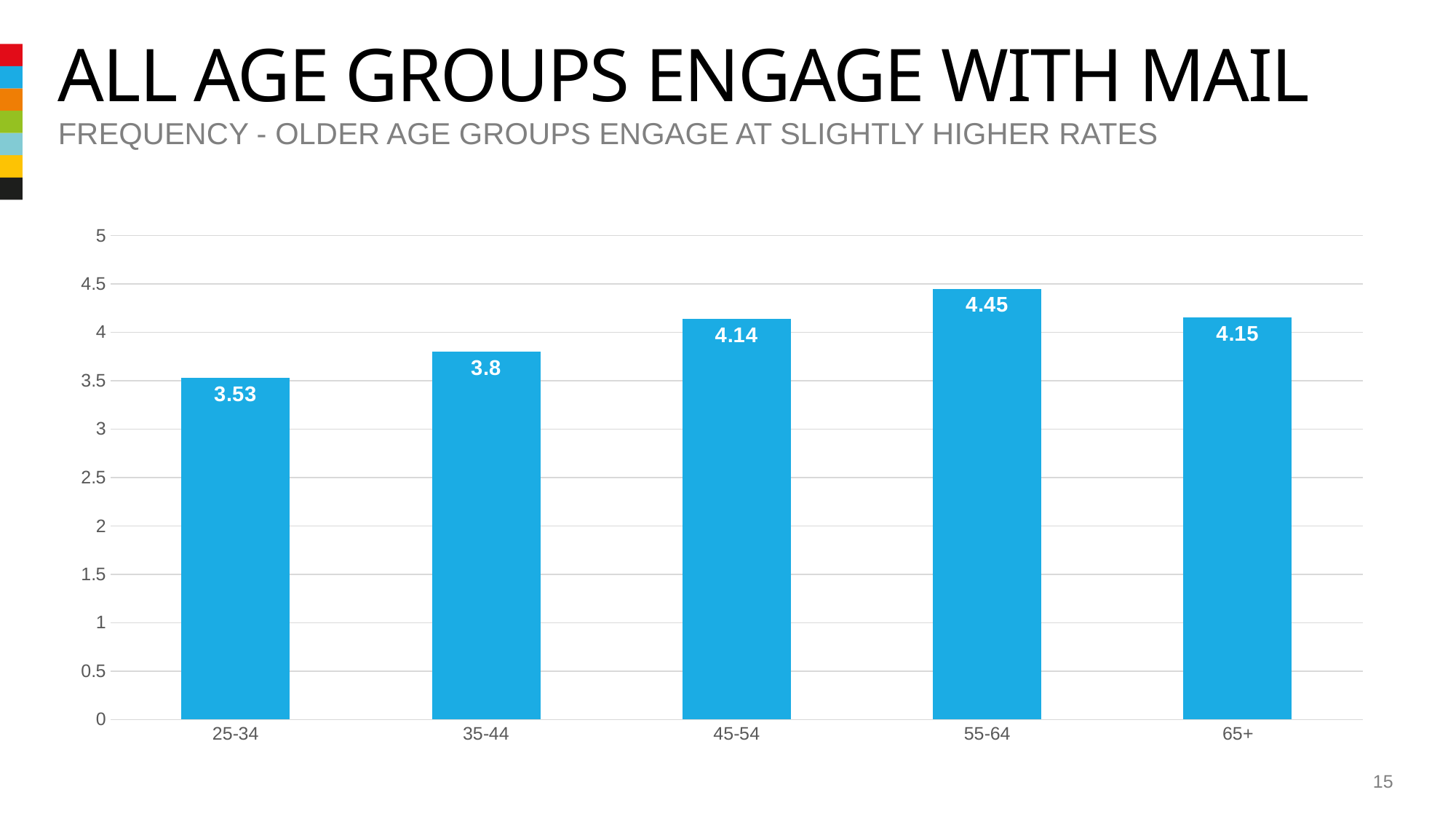
What is the value for the 25-34 age group? 3.53 Which has a larger value, 35-44 or 65+? 65+ What is the value for the 55-64 age group? 4.45 What kind of chart is shown on the slide? Bar chart What is the value for the 35-44 age group? 3.8 What is the value for the 45-54 age group? 4.14 Which age group has the lowest value? 25-34 Which age group has the highest value? 55-64 What is the difference between the values for 55-64 and 25-34? 0.92 What is the title of the slide? ALL AGE GROUPS ENGAGE WITH MAIL How many age groups are shown in the chart? 5 What is the value for the 65+ age group? 4.15